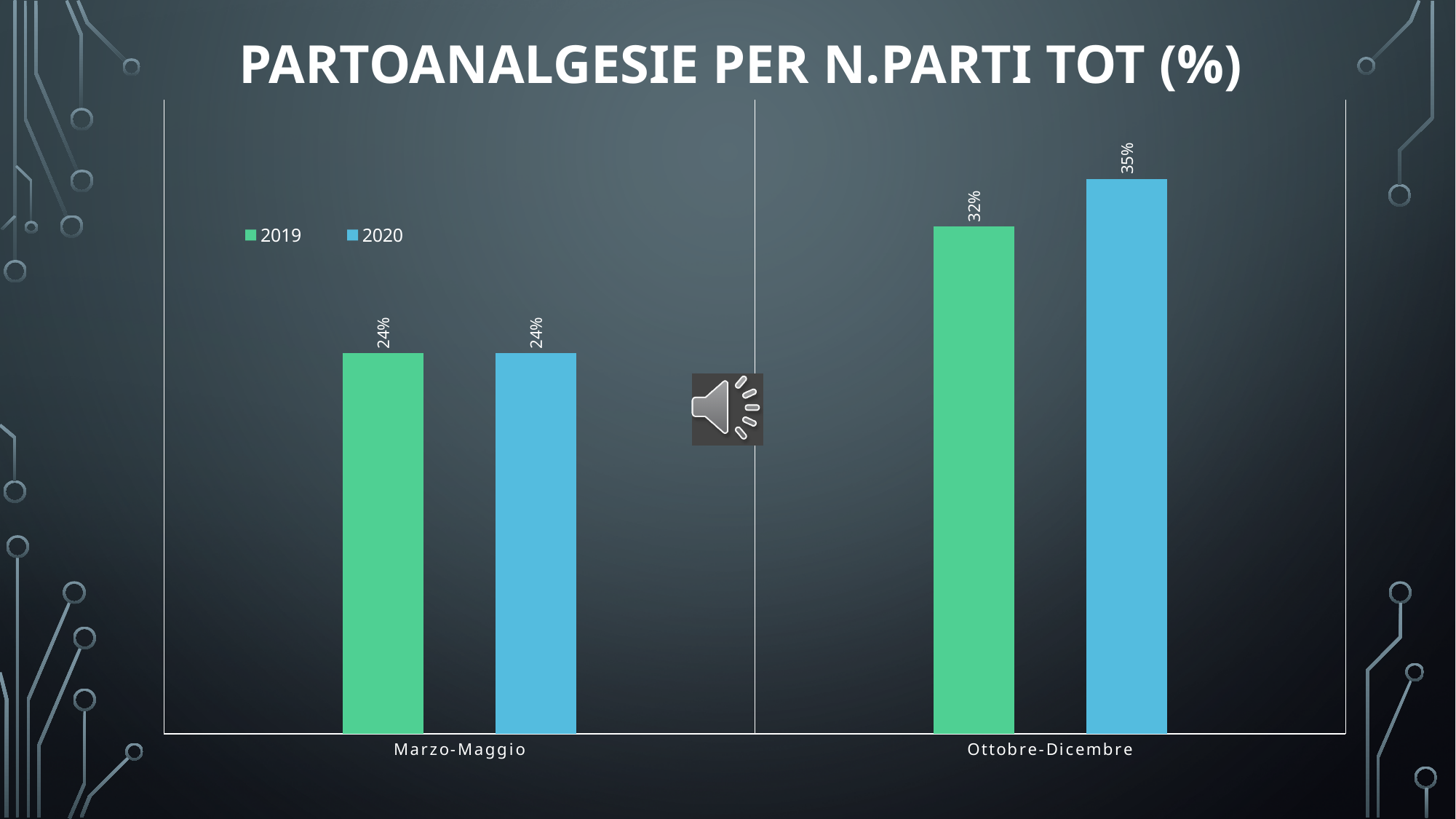
What is the value for 2019 in Ottobre-Dicembre? 32% What is the difference between the 2019 values for Ottobre-Dicembre and Marzo-Maggio? 8% Which category has the lowest value for the 2019 series? Marzo-Maggio How many categories are shown on the x axis? 2 What is the value for 2019 in Marzo-Maggio? 24% Which category has the highest value for the 2020 series? Ottobre-Dicembre Which is larger in Ottobre-Dicembre, the 2019 value or the 2020 value? 2020 How many series does the legend list? 2 What is the difference between the 2020 and 2019 values in Ottobre-Dicembre? 3% What is the value for 2020 in Marzo-Maggio? 24% What kind of chart is shown on the slide? Bar chart What is the value for 2020 in Ottobre-Dicembre? 35%